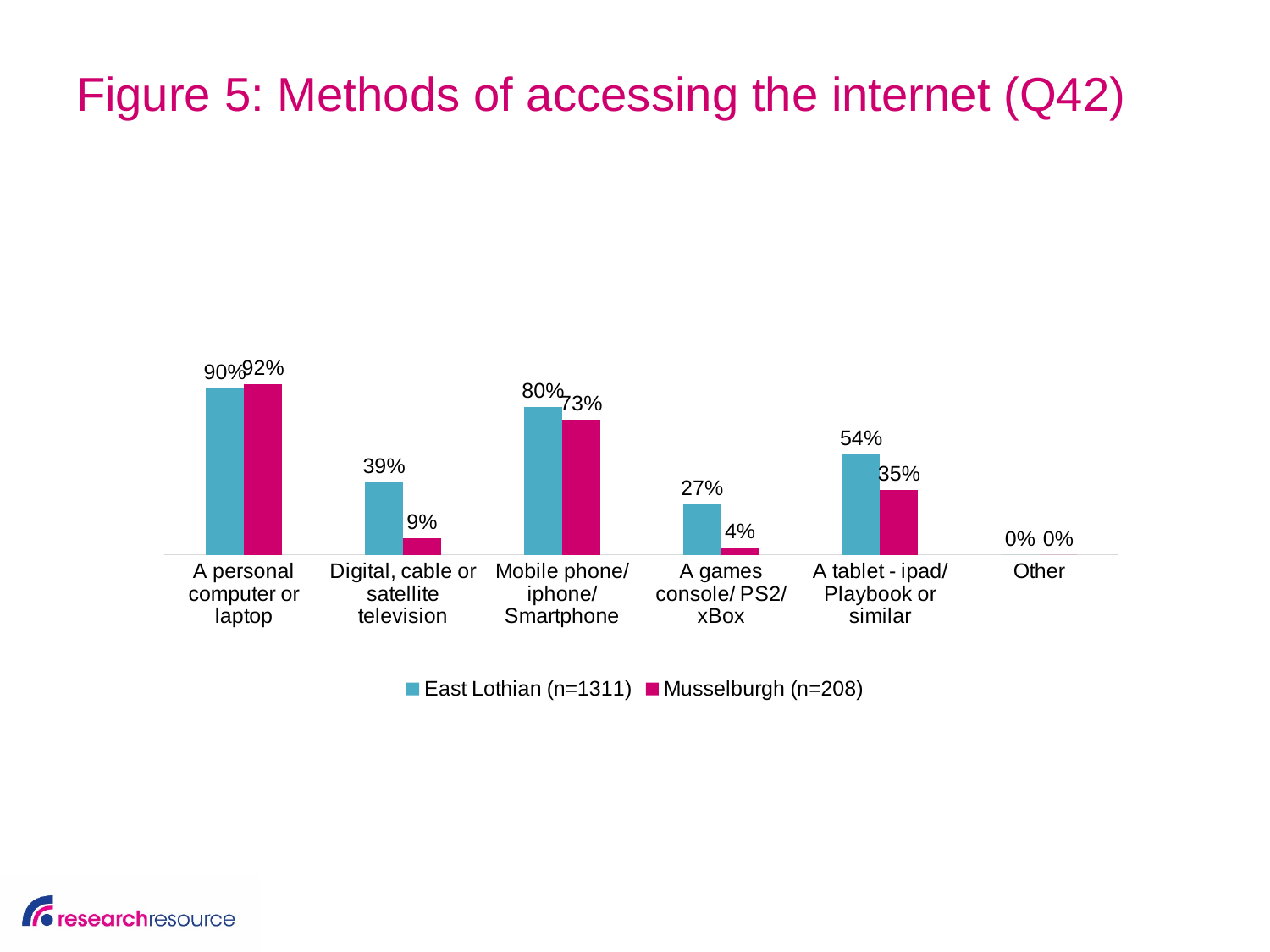
What is the East Lothian value for 'A tablet - ipad/ Playbook or similar'? 54% Which category has the highest Musselburgh value? A personal computer or laptop How many series does the legend list? 2 What kind of chart is shown on the slide? Bar chart Which category has the lowest East Lothian value? Other What is the Musselburgh value for 'Mobile phone/ iphone/ Smartphone'? 73% What is the East Lothian value for 'A personal computer or laptop'? 90% What is the Musselburgh value for 'Digital, cable or satellite television'? 9% How many categories are shown on the x axis? 6 Which is larger for 'A tablet - ipad/ Playbook or similar': the East Lothian value or the Musselburgh value? East Lothian What is the sample size (n) for Musselburgh shown in the legend? 208 What is the difference between the East Lothian and Musselburgh values for 'A games console/ PS2/ xBox'? 23%